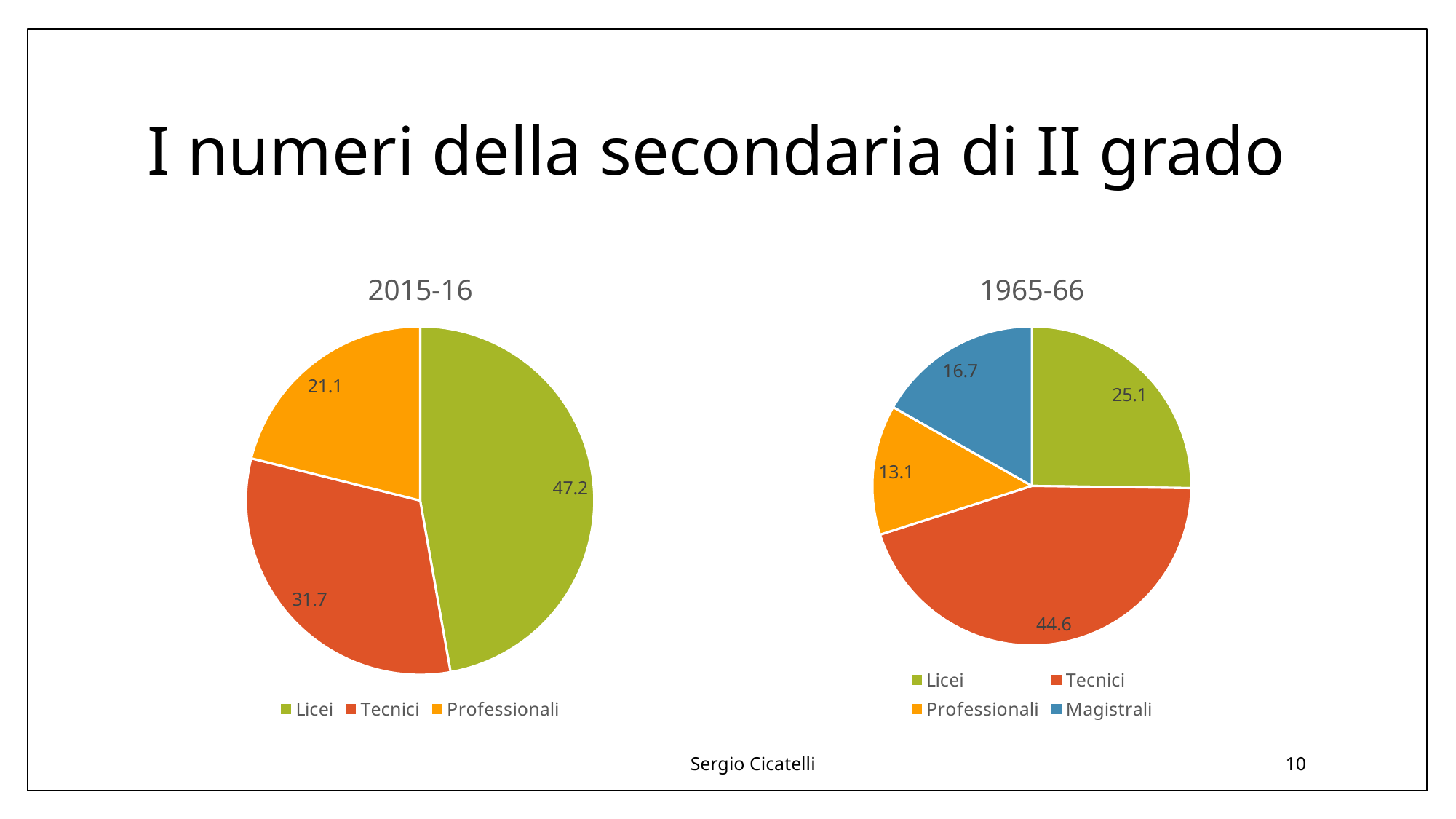
How many slices does the 1965-66 chart have? 4 In the 1965-66 chart, what is the value for Magistrali? 16.7 In the 2015-16 chart, what is the value for Licei? 47.2 In the 2015-16 chart, what is the difference between the values for Licei and Tecnici? 15.5 In the 1965-66 chart, what is the value for Professionali? 13.1 In the 1965-66 chart, which category has the largest slice? Tecnici In the 2015-16 chart, which category has the largest slice? Licei In the 1965-66 chart, which category has the smallest slice? Professionali Which category appears in the legend of the 1965-66 chart but not in the legend of the 2015-16 chart? Magistrali In the 1965-66 chart, which is larger, the value for Licei or the value for Magistrali? Licei What type of chart is the 2015-16 chart? Pie chart In the 2015-16 chart, what is the value for Tecnici? 31.7